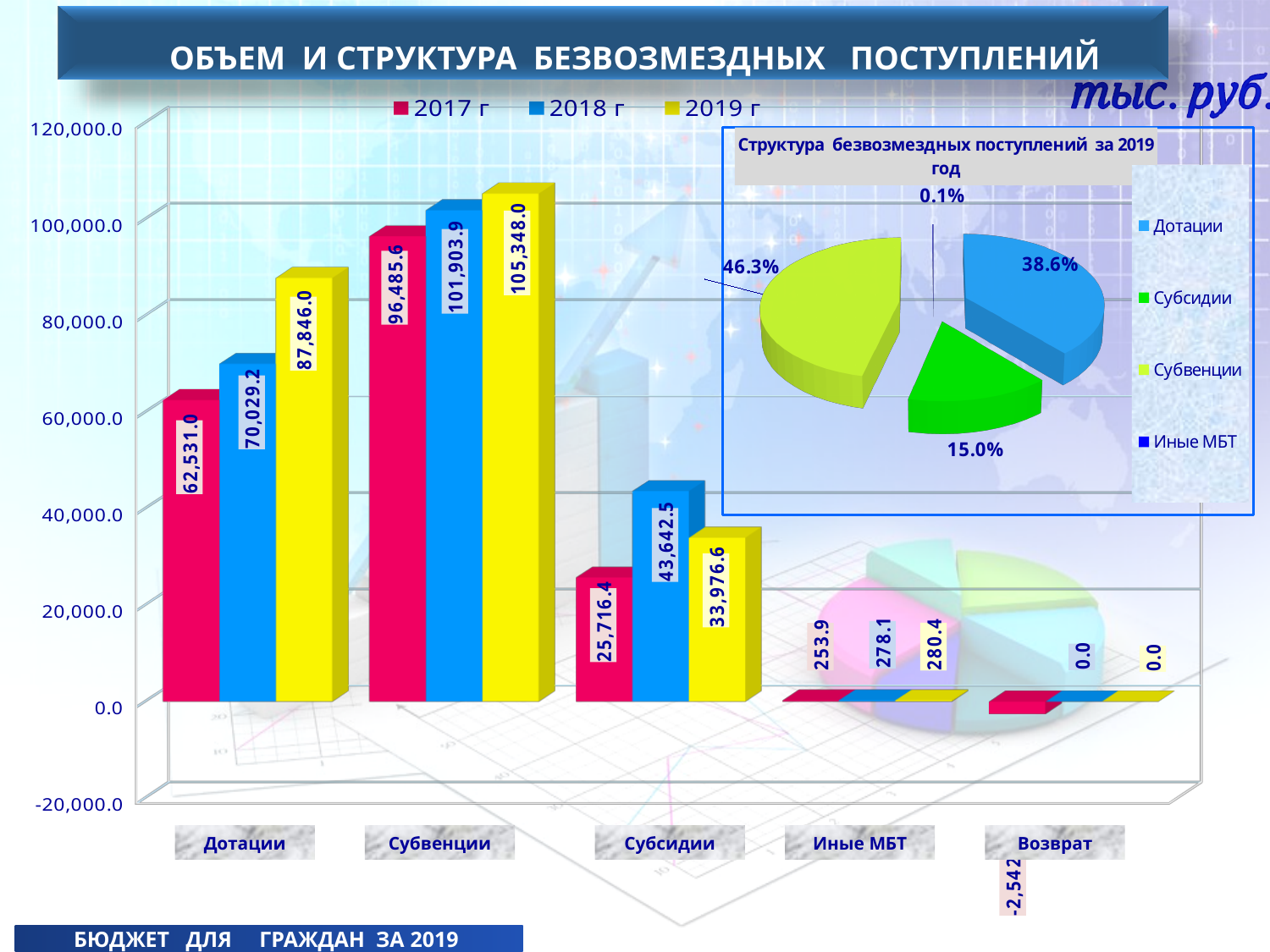
How many series does the legend of the bar chart list? 3 In the bar chart, what is the value for Дотации in 2019 г? 87,846.0 In the bar chart, what is the value for Субвенции in 2017 г? 96,485.6 In the bar chart, what is the value for Субсидии in 2018 г? 43,642.5 In the bar chart, which category has the highest value in 2019 г? Субвенции In the pie chart 'Структура безвозмездных поступлений за 2019 год', which category has the smallest share? Иные МБТ In the bar chart, what is the value for Иные МБТ in 2019 г? 280.4 In the bar chart, what is the difference between the 2019 г and 2017 г values for Дотации? 25,315.0 What type of chart is the large chart on the left of the slide? bar chart In the pie chart 'Структура безвозмездных поступлений за 2019 год', what share does Субвенции have? 46.3% In the bar chart, do the values for Субвенции rise or fall from 2017 г to 2019 г? rise In the bar chart, which is larger for Субсидии: the 2018 г value or the 2019 г value? 2018 г